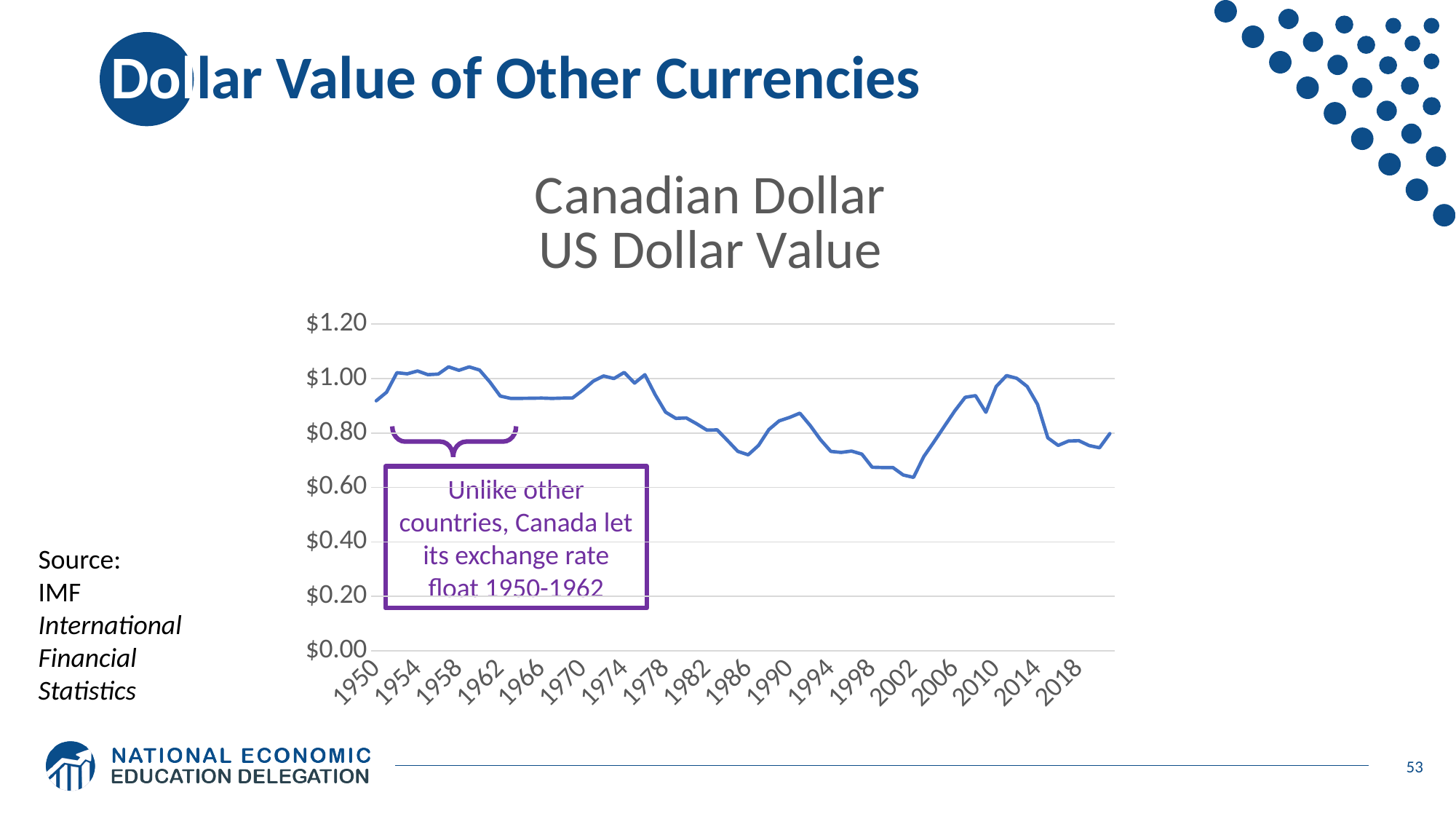
Is the value for 1958 greater or less than $1.00? greater What is the title of the chart? Canadian Dollar US Dollar Value Is the value for 1966 greater or less than $1.00? less Does the value rise or fall between 1974 and 1986? fall Is the value for 1978 greater or less than $0.80? greater What kind of chart is shown on the slide? line chart What is the highest value shown on the vertical axis of the chart? $1.20 How many year labels are shown along the x axis of the chart? 18 Does the value rise or fall between 2002 and 2010? rise Which year has the larger value, 1958 or 2002? 1958